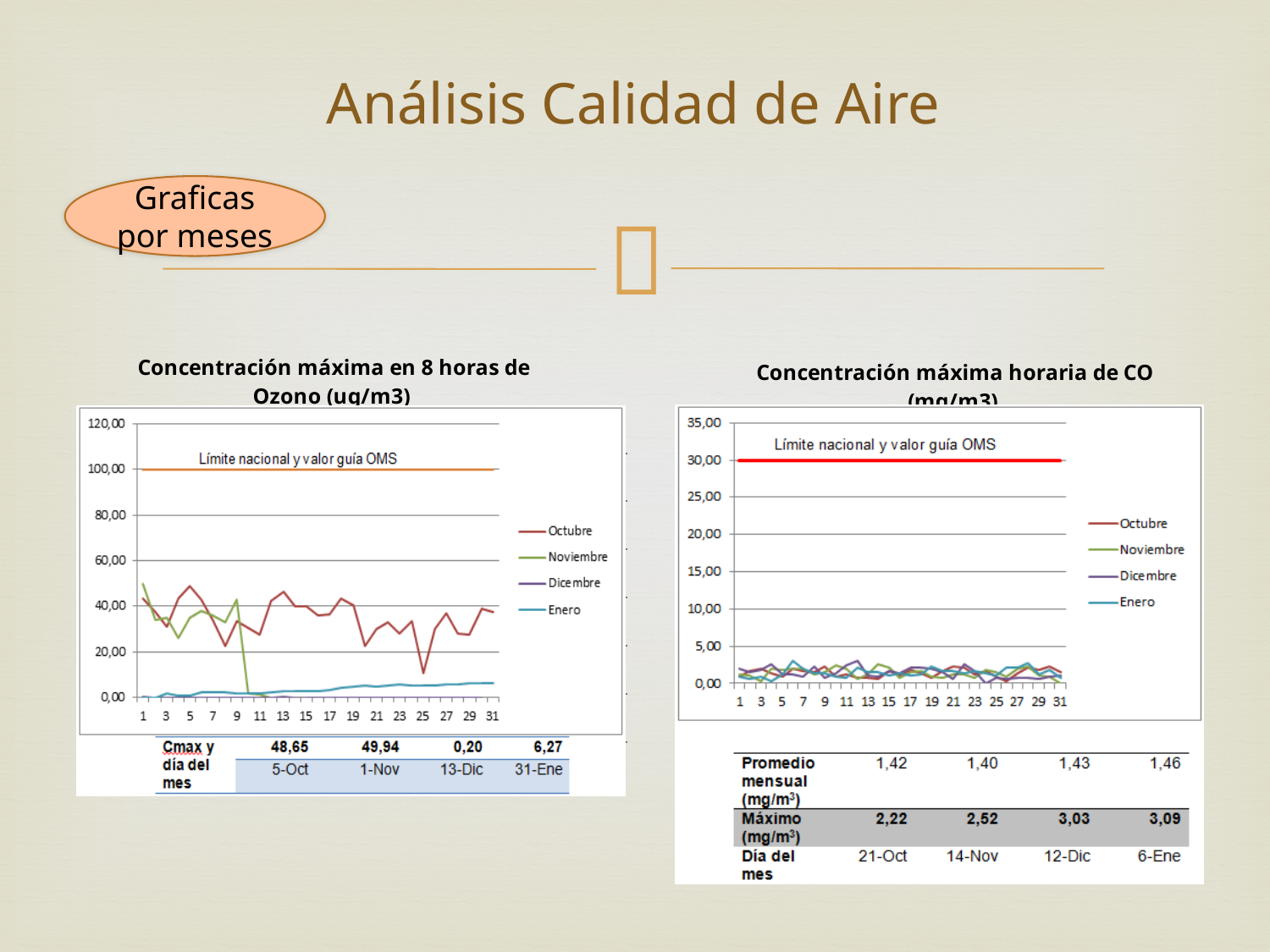
What type of chart is the 'Concentración máxima en 8 horas de Ozono (ug/m3)' chart? line chart In the 'Concentración máxima en 8 horas de Ozono (ug/m3)' chart, is the Enero value on day 31 greater or less than 20? less How many series does the legend of the 'Concentración máxima horaria de CO (mg/m3)' chart list? 4 In the 'Concentración máxima horaria de CO (mg/m3)' chart, at what y-axis value is the 'Límite nacional y valor guía OMS' line drawn? 30,00 In the table under the 'Concentración máxima horaria de CO (mg/m3)' chart, which month has the highest Máximo value? Enero (6-Ene, 3,09) In the table under the 'Concentración máxima en 8 horas de Ozono (ug/m3)' chart, which month has the lowest Cmax value? Diciembre (13-Dic, 0,20) In the table under the 'Concentración máxima en 8 horas de Ozono (ug/m3)' chart, what is the Cmax value for 1-Nov? 49,94 In the 'Concentración máxima en 8 horas de Ozono (ug/m3)' chart, is the Octubre value on day 5 greater or less than 100? less In the table under the 'Concentración máxima horaria de CO (mg/m3)' chart, what is the Máximo value for 12-Dic? 3,03 In the table under the 'Concentración máxima en 8 horas de Ozono (ug/m3)' chart, what is the difference between the Cmax values for 1-Nov and 5-Oct? 1,29 In the 'Concentración máxima en 8 horas de Ozono (ug/m3)' chart, at what y-axis value is the 'Límite nacional y valor guía OMS' line drawn? 100,00 In the table under the 'Concentración máxima horaria de CO (mg/m3)' chart, which is larger, the Promedio mensual for Octubre (1,42) or for Enero (1,46)? Enero (1,46)